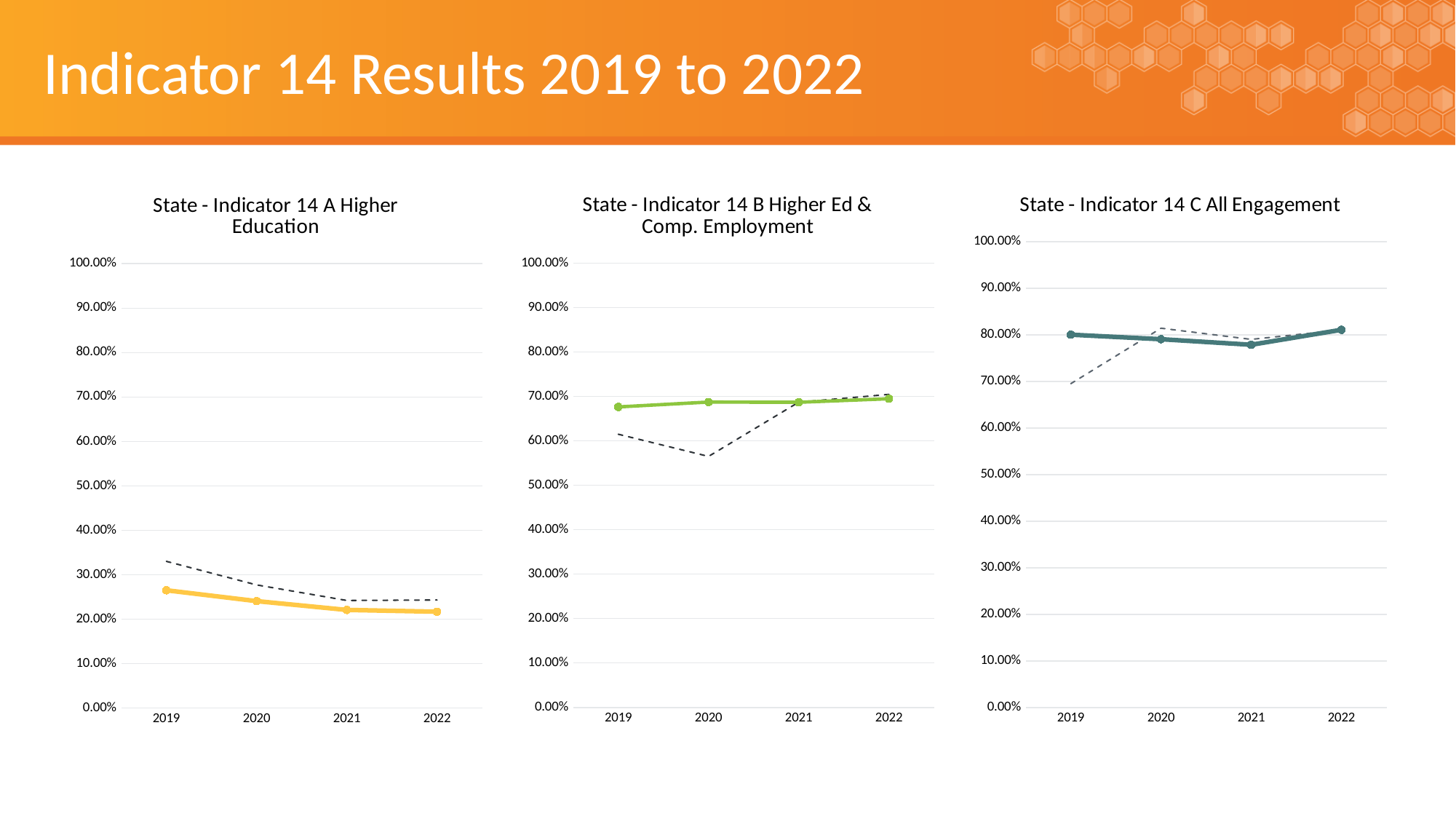
What kind of chart is "State - Indicator 14 A Higher Education"? line chart In the "State - Indicator 14 A Higher Education" chart, is the solid-line value for 2019 greater or less than 30.00%? less In the "State - Indicator 14 A Higher Education" chart, is the solid-line value for 2022 greater or less than 20.00%? greater In the "State - Indicator 14 B Higher Ed & Comp. Employment" chart, is the solid-line value for 2019 greater or less than 60.00%? greater In the "State - Indicator 14 A Higher Education" chart, do the solid-line values rise or fall from 2019 to 2022? fall In the "State - Indicator 14 A Higher Education" chart, which year has the highest solid-line value? 2019 How many charts are shown on the slide? 3 In the "State - Indicator 14 B Higher Ed & Comp. Employment" chart, do the solid-line values rise or fall from 2019 to 2022? rise How many years are plotted on the x axis of the "State - Indicator 14 C All Engagement" chart? 4 In the "State - Indicator 14 C All Engagement" chart, which year has the lowest solid-line value? 2021 In the "State - Indicator 14 B Higher Ed & Comp. Employment" chart, which year has the lowest solid-line value? 2019